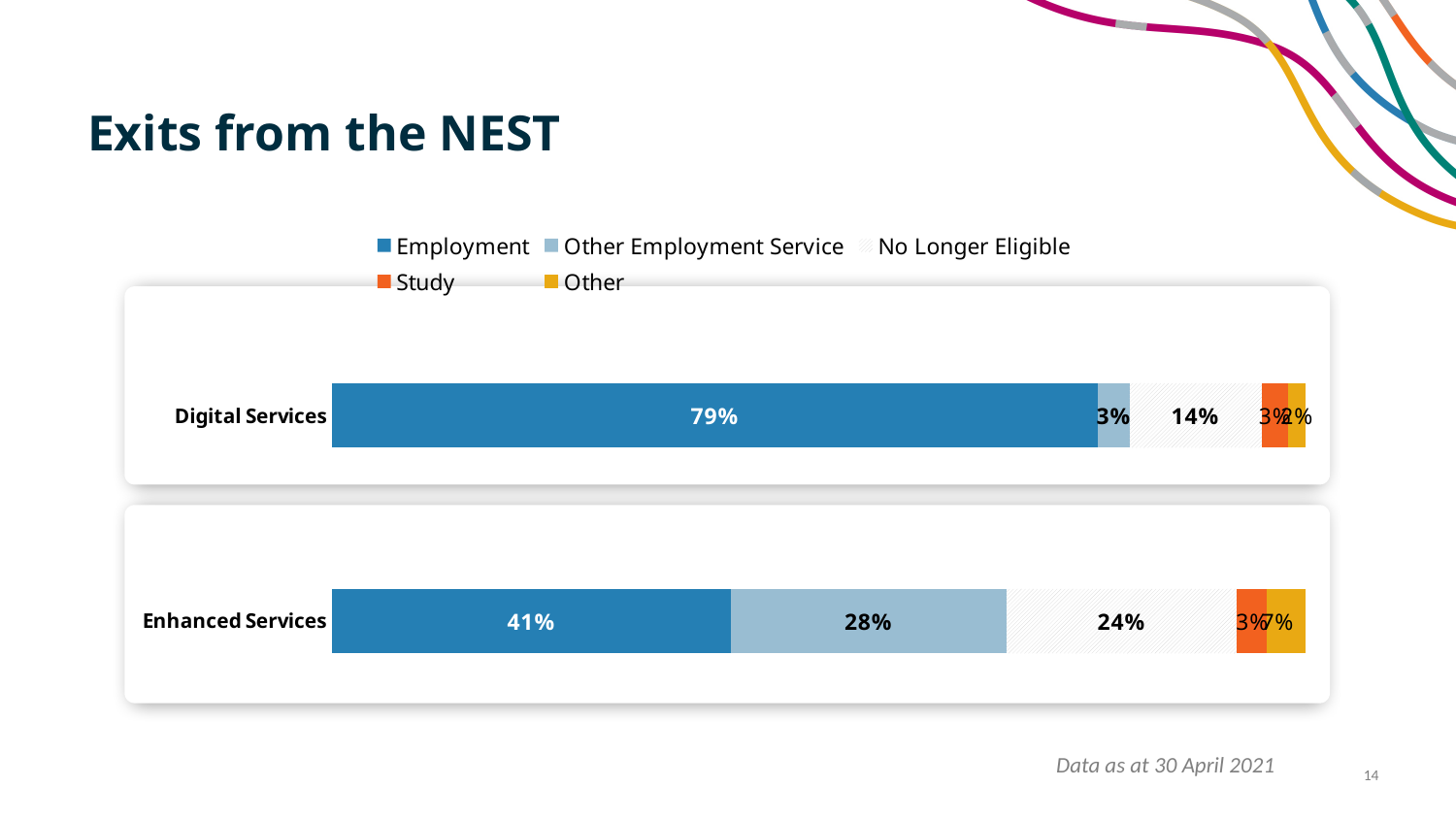
What is the No Longer Eligible value for Enhanced Services? 24% What is the title of the chart on the slide? Exits from the NEST How many series does the legend list? 5 What is the No Longer Eligible value for Digital Services? 14% How many categories are plotted in the chart? 2 What is the Employment value for Enhanced Services? 41% What is the Employment value for Digital Services? 79% What is the Other Employment Service value for Enhanced Services? 28% What kind of chart is shown on the slide? Bar chart Which category has the larger Employment share, Digital Services or Enhanced Services? Digital Services What is the Other Employment Service value for Digital Services? 3% What is the difference between the Employment values for Digital Services and Enhanced Services? 38 percentage points